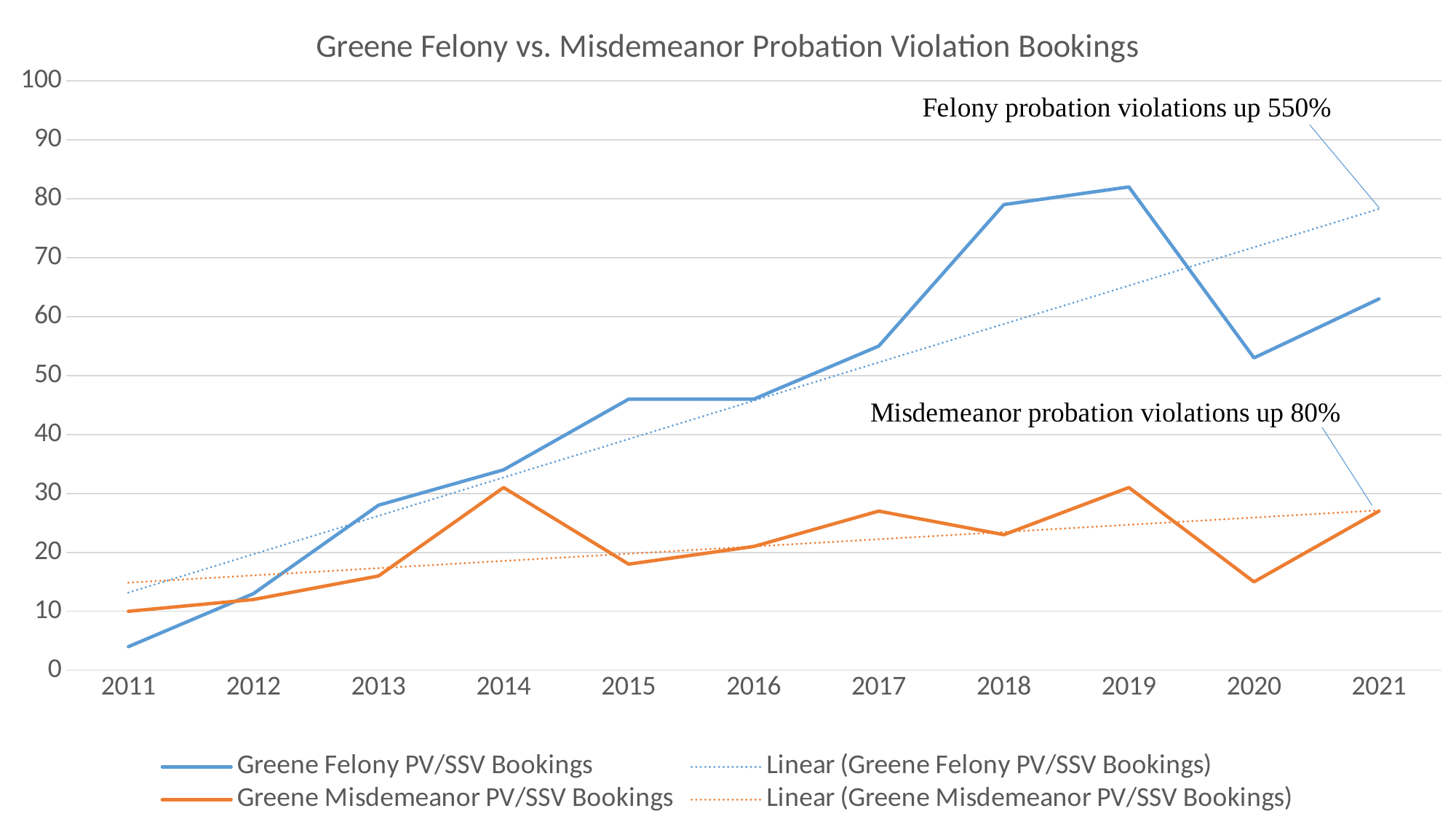
How many years are shown on the x axis of the chart? 11 According to the annotation on the chart, by what percentage are felony probation violations up? 550% Is the Greene Felony PV/SSV Bookings value for 2018 greater or less than 70? greater Is the Greene Misdemeanor PV/SSV Bookings value for 2020 greater or less than 20? less What kind of chart is shown on the slide? line chart Is the Greene Felony PV/SSV Bookings value for 2011 greater or less than 10? less In 2018, which series has the larger value: Greene Felony PV/SSV Bookings or Greene Misdemeanor PV/SSV Bookings? Greene Felony PV/SSV Bookings How many entries does the chart's legend list? 4 What is the title of the chart? Greene Felony vs. Misdemeanor Probation Violation Bookings In 2011, which series has the larger value: Greene Felony PV/SSV Bookings or Greene Misdemeanor PV/SSV Bookings? Greene Misdemeanor PV/SSV Bookings In which year is the Greene Felony PV/SSV Bookings value lowest? 2011